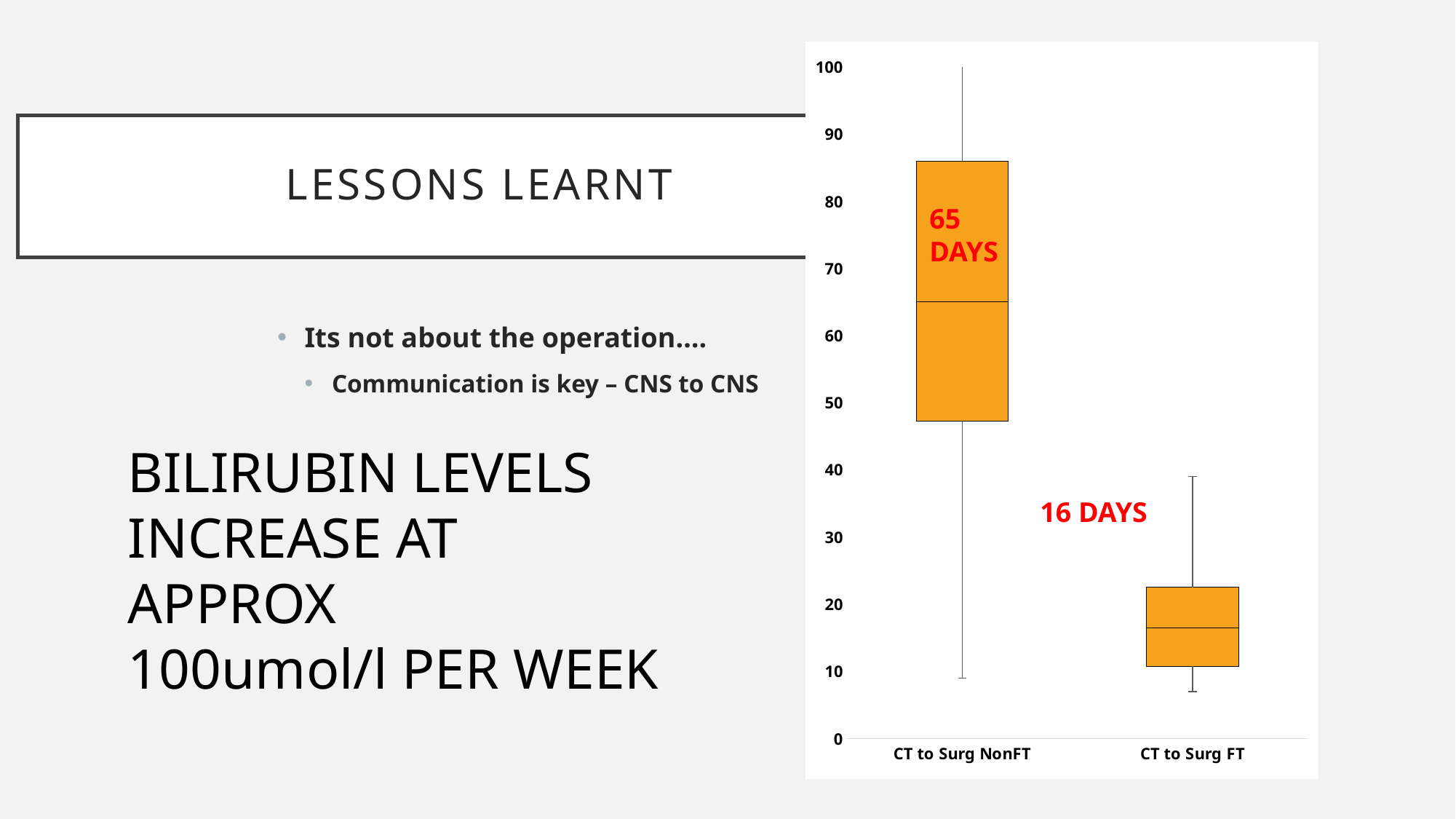
Is the top of the CT to Surg FT box greater or less than 30? less What kind of chart is shown on the slide? Box-and-whisker plot Which category has the higher labelled value, CT to Surg NonFT or CT to Surg FT? CT to Surg NonFT What value is labelled on the box for CT to Surg NonFT? 65 DAYS Is the median line of the CT to Surg NonFT box greater or less than 60? greater Which category has the highest labelled value? CT to Surg NonFT What value is labelled for CT to Surg FT? 16 DAYS Which category has the lowest labelled value? CT to Surg FT What colour are the boxes in the chart? Orange What is the difference between the labelled values for CT to Surg NonFT and CT to Surg FT? 49 days How many categories are shown on the x axis of the chart? 2 Is the top of the upper whisker for CT to Surg FT greater or less than 50? less